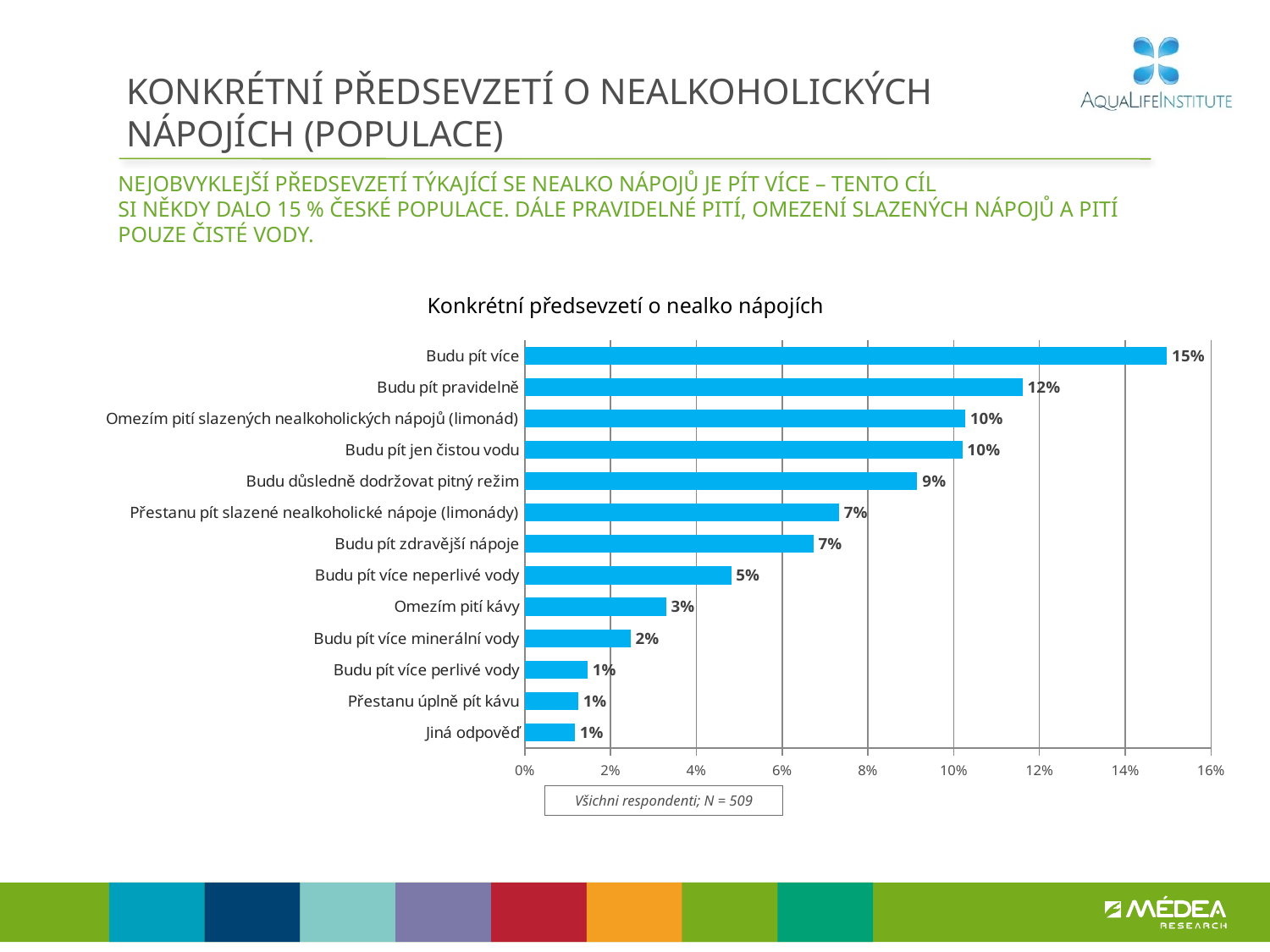
What is the number of respondents (N) stated below the chart? 509 Which is larger: "Budu pít více neperlivé vody" or "Budu pít zdravější nápoje"? Budu pít zdravější nápoje What value is shown for "Budu pít více"? 15% Which category has the highest value? Budu pít více What value is shown for "Budu pít pravidelně"? 12% What is the difference between "Budu pít více" and "Budu pít pravidelně"? 3% What value is shown for "Budu důsledně dodržovat pitný režim"? 9% What type of chart is shown on the slide? Bar chart What value is shown for "Budu pít více minerální vody"? 2% What value is shown for "Omezím pití kávy"? 3% How many categories are shown in the chart? 13 What is the title of the chart? Konkrétní předsevzetí o nealko nápojích